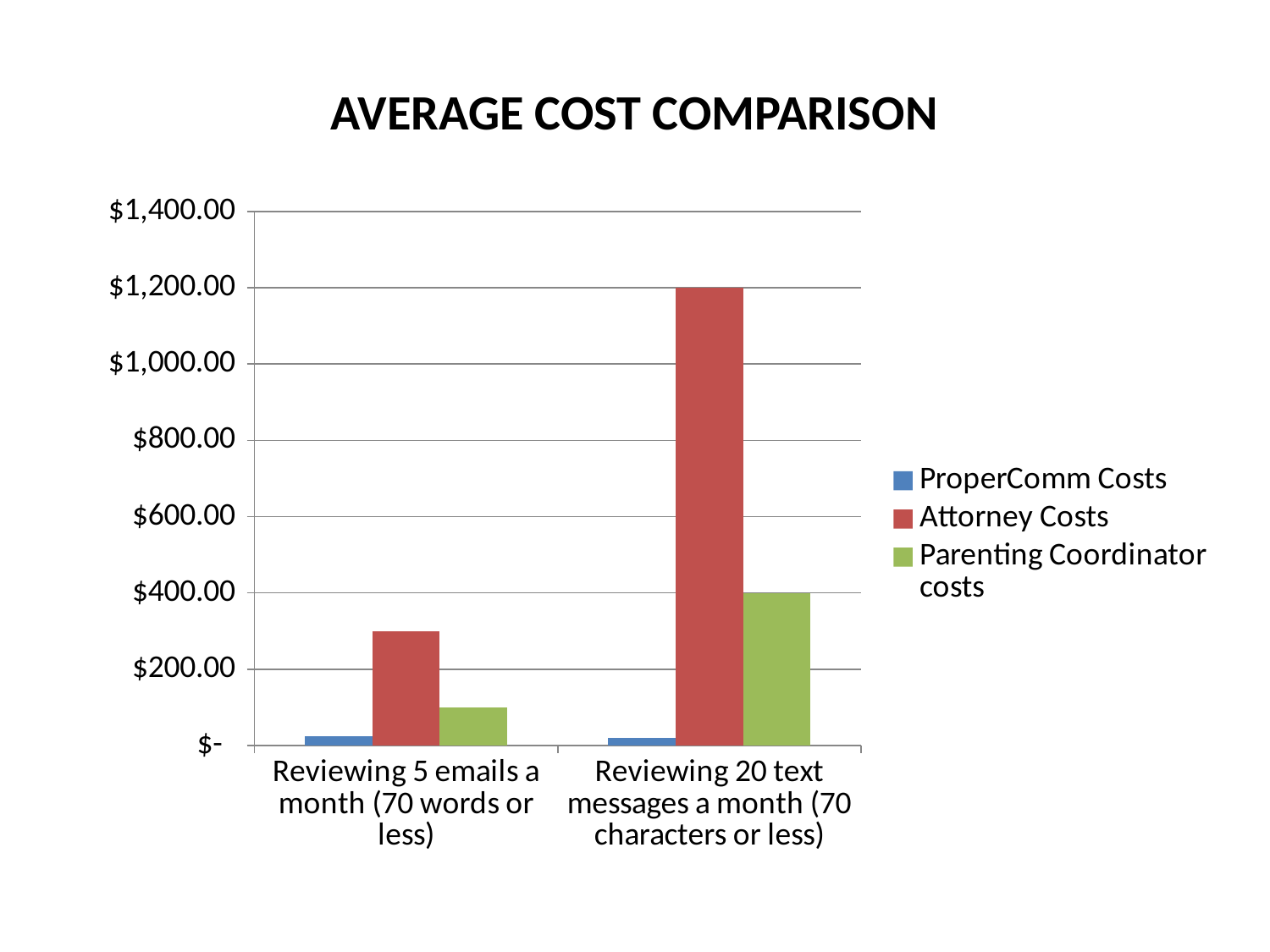
What is the title of the chart? AVERAGE COST COMPARISON What type of chart is shown on the slide? bar chart How many series does the legend list? 3 Which series has the lowest value for Reviewing 20 text messages a month (70 characters or less)? ProperComm Costs Is the Attorney Costs value for Reviewing 5 emails a month (70 words or less) greater or less than $200.00? greater Is the Parenting Coordinator costs value for Reviewing 5 emails a month (70 words or less) greater or less than $200.00? less What is the difference between Attorney Costs and Parenting Coordinator costs for Reviewing 20 text messages a month (70 characters or less)? $800.00 Which series has the highest value for Reviewing 5 emails a month (70 words or less)? Attorney Costs What is the Parenting Coordinator costs value for Reviewing 20 text messages a month (70 characters or less)? $400.00 Which is larger: Attorney Costs for Reviewing 5 emails a month or Attorney Costs for Reviewing 20 text messages a month? Reviewing 20 text messages a month What is the Attorney Costs value for Reviewing 20 text messages a month (70 characters or less)? $1,200.00 How many categories are shown on the x axis? 2